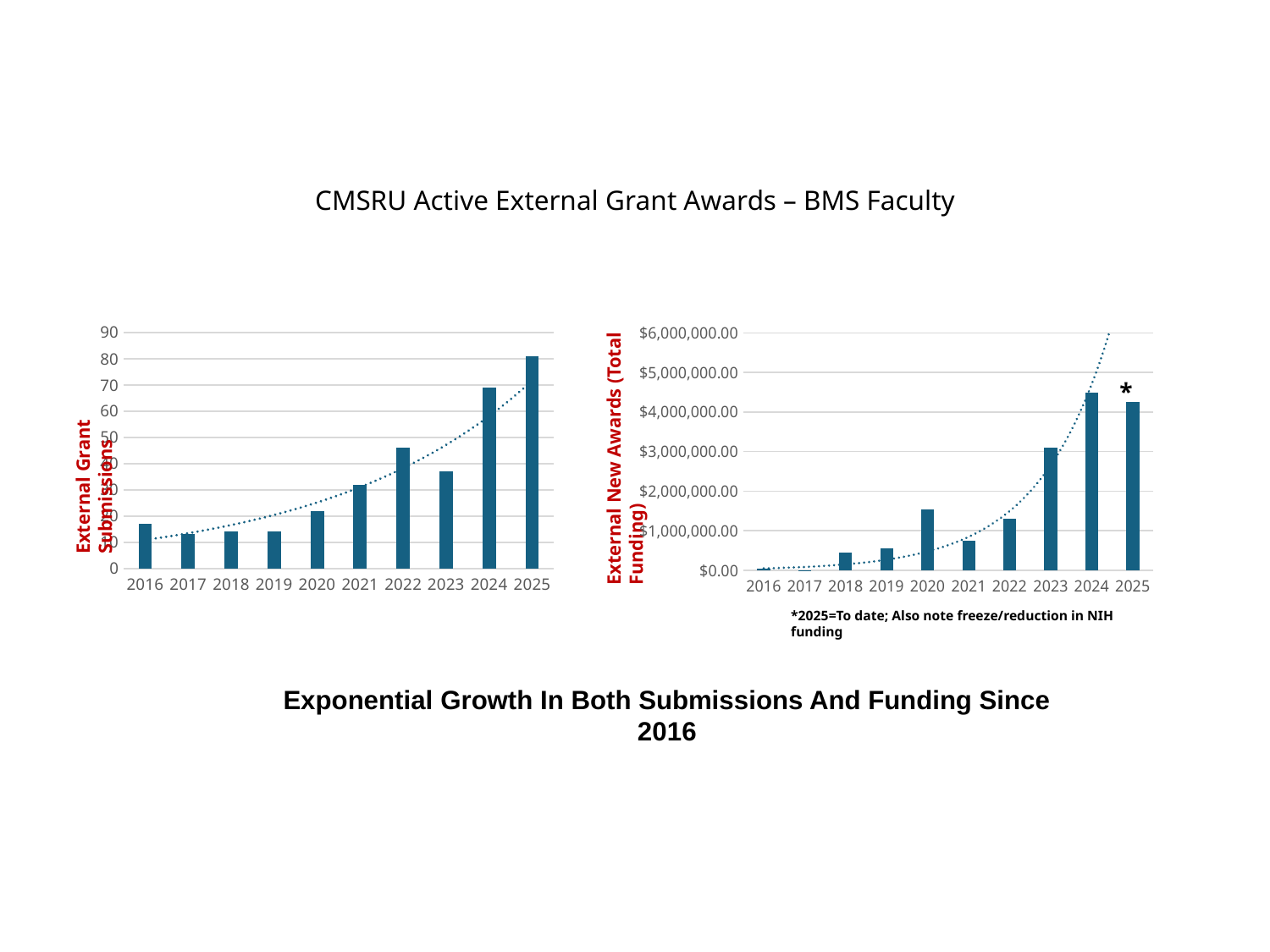
In the right chart (External New Awards (Total Funding)), which year has the highest funding? 2024 In the left chart (External Grant Submissions), which year has the highest number of submissions? 2025 What is the title shown above the two charts? CMSRU Active External Grant Awards – BMS Faculty What kind of chart is the left chart (External Grant Submissions)? bar chart In the left chart (External Grant Submissions), is the value for 2016 greater or less than 20? less In the left chart (External Grant Submissions), which is larger, the value for 2022 or the value for 2023? 2022 In the right chart (External New Awards (Total Funding)), which is larger, the value for 2020 or the value for 2022? 2020 In the left chart (External Grant Submissions), is the value for 2025 greater or less than 70? greater How many years are shown on the x axis of the left chart (External Grant Submissions)? 10 In the right chart (External New Awards (Total Funding)), is the value for 2021 greater or less than $1,000,000.00? less In the left chart (External Grant Submissions), do the values generally rise or fall from 2016 to 2025? rise